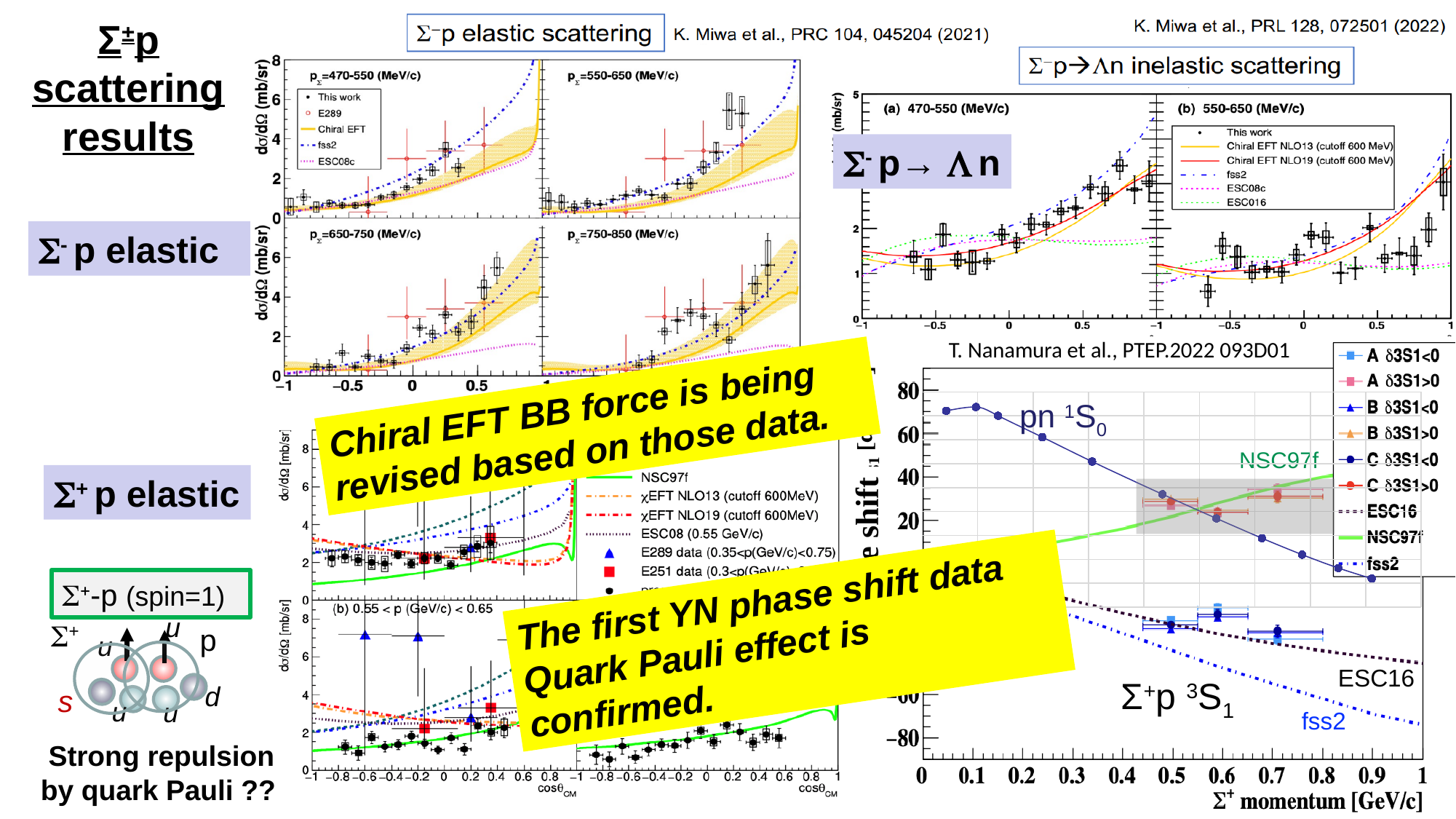
In the phase shift chart at the bottom right, how many entries does the legend list? 9 In the phase shift chart at the bottom right, does the pn ¹S₀ curve rise or fall as momentum increases beyond 0.1 GeV/c? fall In the phase shift chart at the bottom right, is the pn ¹S₀ curve value at 0.9 GeV/c greater or less than 0? less What kind of chart is the phase shift plot at the bottom right? line chart In the Σ⁻p→Λn inelastic scattering chart at the top right, how many entries does the legend list? 6 In the Σ⁻p elastic scattering chart at the top left, how many entries does the legend list? 5 In the Σ⁻p→Λn inelastic scattering chart at the top right, how many panels are shown? 2 In the phase shift chart at the bottom right, what is the x-axis label? Σ⁺ momentum [GeV/c] In the Σ⁻p elastic scattering chart at the top left, what momentum range is labelled on the top-left panel? p_Σ=470-550 (MeV/c) In the phase shift chart at the bottom right, is the pn ¹S₀ value at 0.1 GeV/c greater or less than 60? greater In the phase shift chart at the bottom right, are the Σ⁺p ³S₁ data points near 0.5 GeV/c greater or less than 0? less In the Σ⁻p elastic scattering chart at the top left, how many momentum-range panels are shown? 4